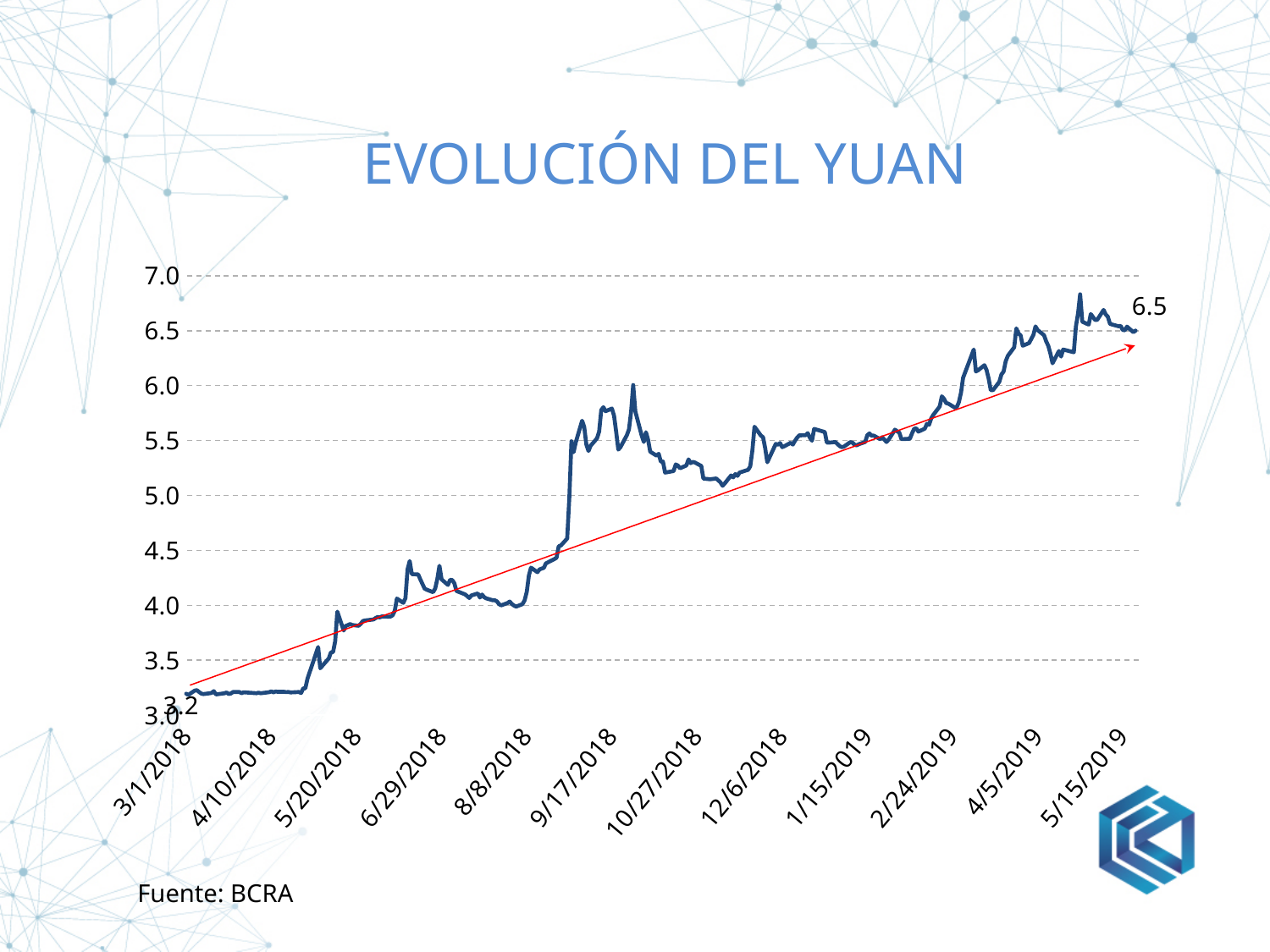
What is the value shown at the start of the series (3/1/2018)? 3.2 Which is larger, the value at 3/1/2018 or the value at 5/15/2019? 5/15/2019 Is the value for 4/10/2018 greater or less than 3.5? less How many date labels are shown on the x axis? 12 Is the value for 10/27/2018 greater or less than 5.0? greater What is the title of the chart? EVOLUCIÓN DEL YUAN What is the value shown at the end of the series (5/15/2019)? 6.5 What is the difference between the final labelled value (6.5) and the initial labelled value (3.2)? 3.3 What kind of chart is shown on the slide? line chart What source is cited below the chart? BCRA Do the values generally rise or fall from 3/1/2018 to 5/15/2019? rise Is the value for 8/8/2018 greater or less than 4.5? less